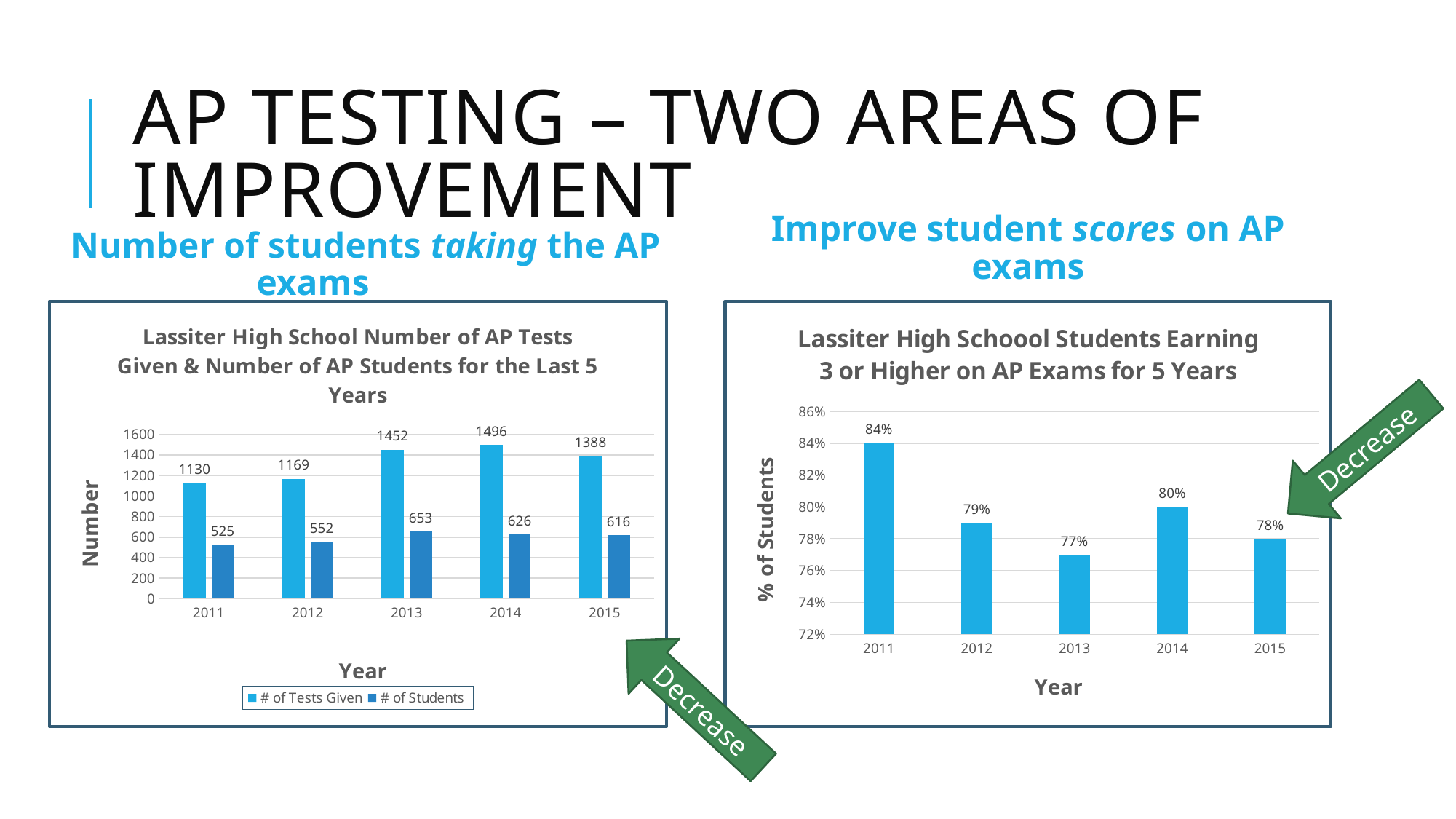
In the right chart, what is the difference between the 2011 and 2013 percentages? 7% In the right chart, how many years are plotted? 5 In the left chart, which year has the lowest number of students? 2011 In the right chart, is the value for 2014 larger or smaller than the value for 2015? Larger In the left chart, what is the difference between the number of tests given in 2014 and in 2015? 108 In the left chart, which year has the highest number of tests given? 2014 In the right chart, which year has the lowest percentage of students earning 3 or higher? 2013 In the left chart, what type of chart is shown? Bar chart In the left chart, what is the number of AP students in 2013? 653 In the left chart, how many AP tests were given in 2014? 1496 In the left chart, how many series does the legend list? 2 In the right chart, what percentage of students earned 3 or higher in 2011? 84%